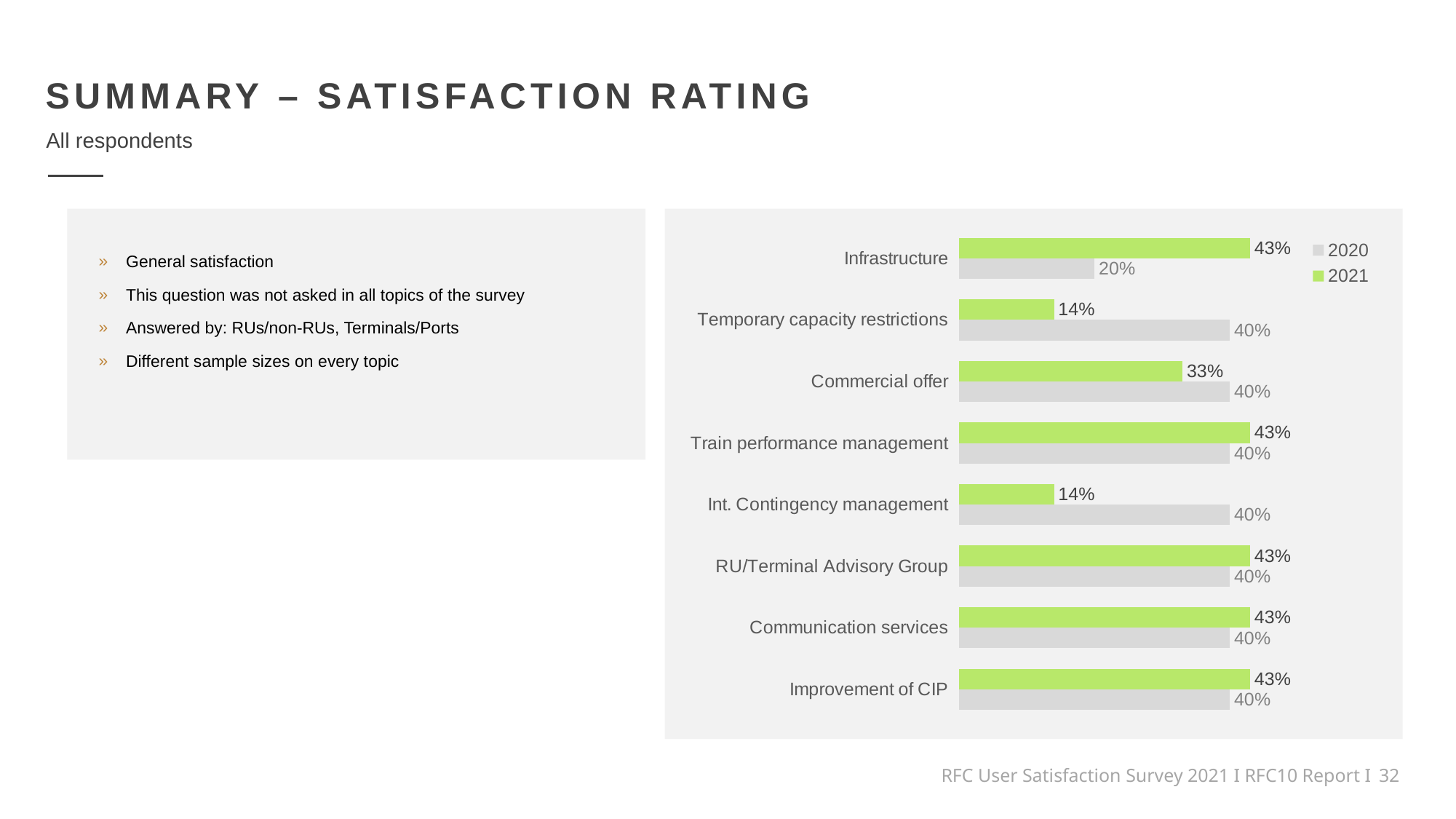
Which is larger for Commercial offer, the 2020 value or the 2021 value? 2020 What is the difference between the 2020 and 2021 values for Temporary capacity restrictions? 26% Which category has the lowest 2020 value? Infrastructure What is the 2020 value for Infrastructure? 20% What kind of chart is shown on the slide? Bar chart What is the 2021 value for Commercial offer? 33% What is the 2020 value for Int. Contingency management? 40% What is the difference between the 2021 and 2020 values for Infrastructure? 23% How many categories are shown in the chart? 8 What is the 2021 value for Temporary capacity restrictions? 14% What is the 2021 value for Infrastructure? 43% How many series does the legend list? 2